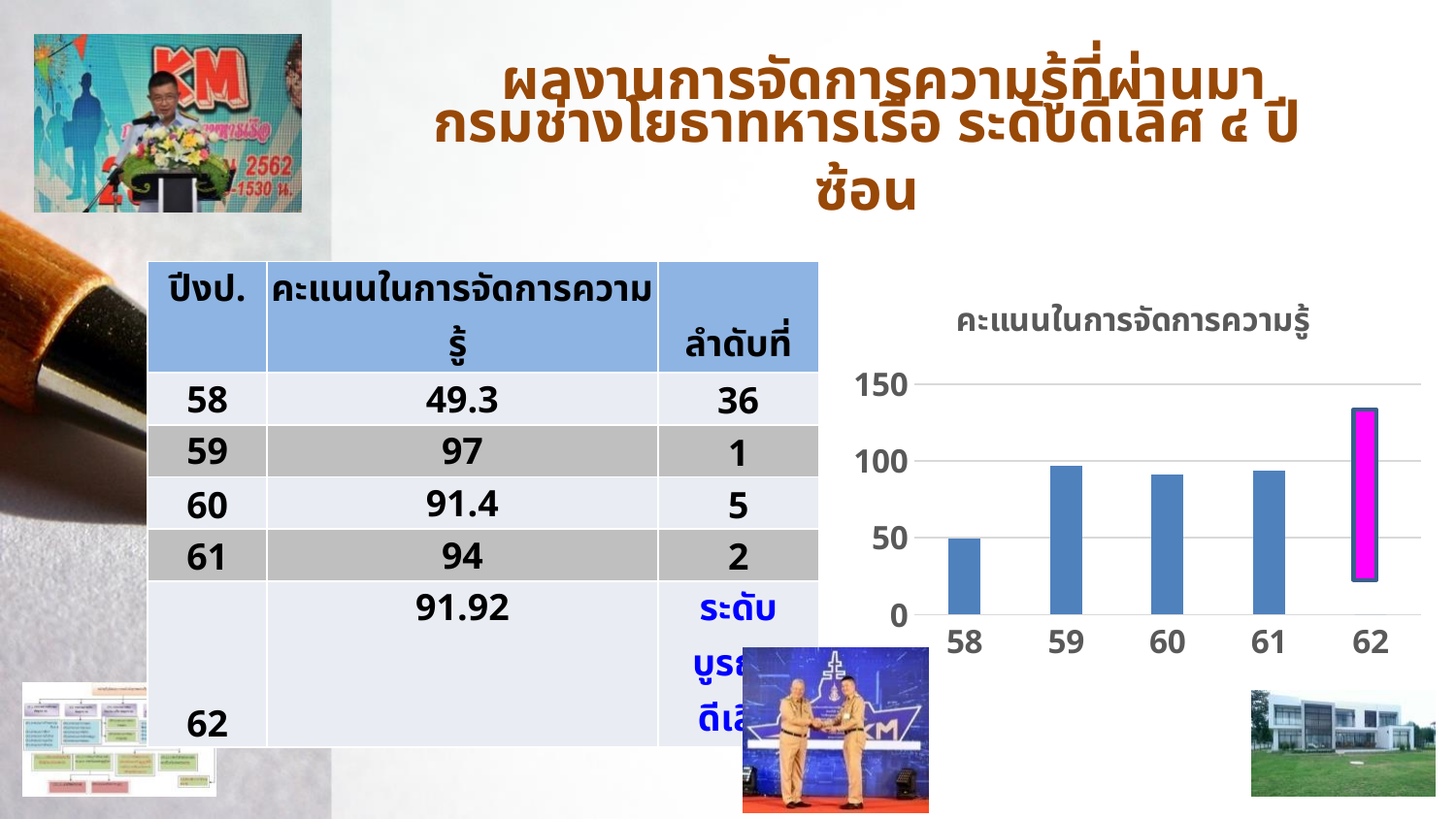
What is the title of the chart on the slide? คะแนนในการจัดการความรู้ Is the value for 58 greater or less than 100? less Which category has the lowest bar in the chart? 58 Is the value for 60 greater or less than 50? greater Does the value rise or fall from 58 to 59 in the chart? rise Is the value for 61 greater or less than 100? less What kind of chart is shown on the slide? bar chart Which is larger in the chart, the value for 58 or the value for 59? 59 How many categories are shown on the x axis of the chart? 5 What is the highest value shown on the y axis of the chart? 150 Which is larger in the chart, the value for 58 or the value for 61? 61